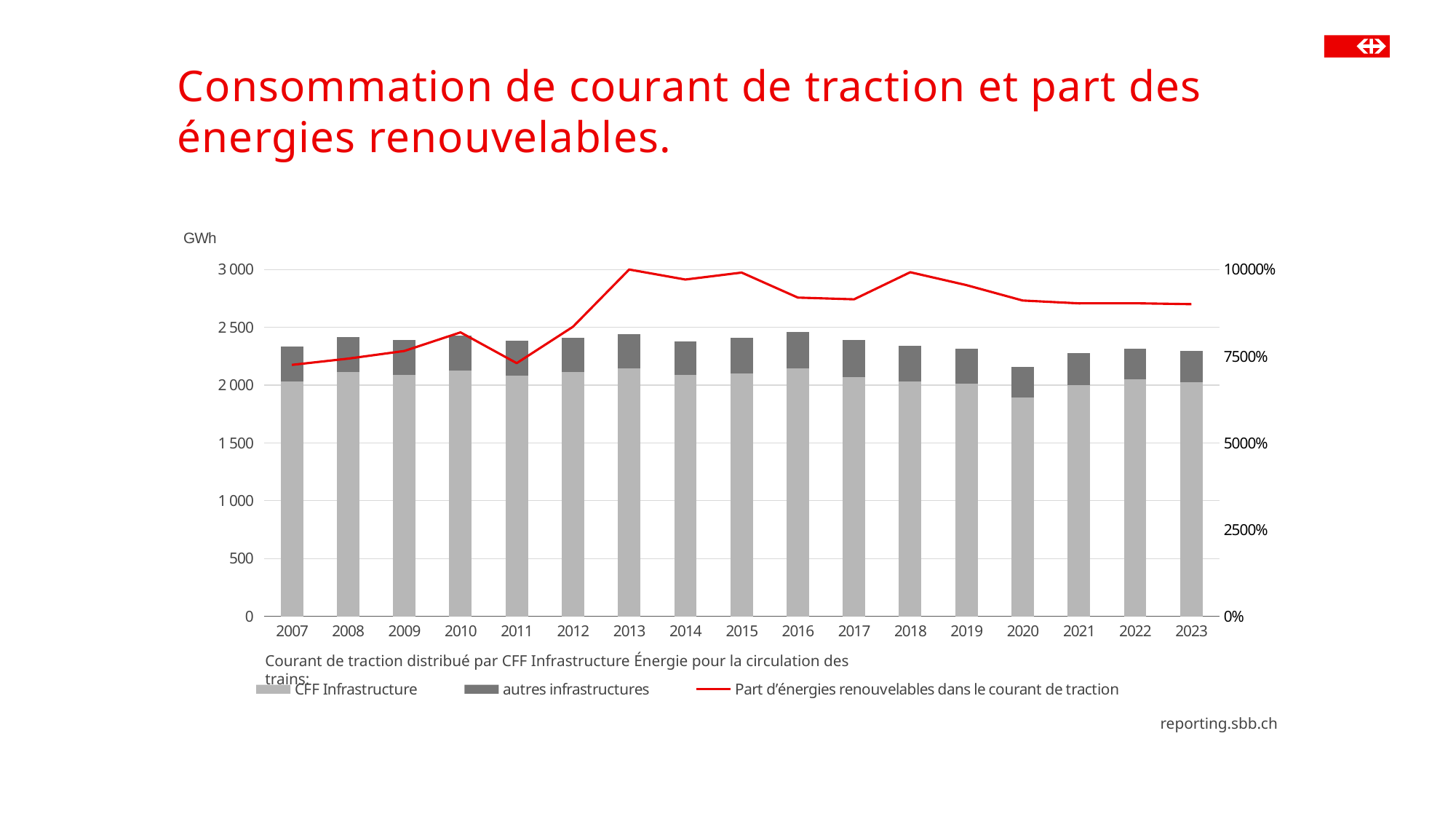
Is the value of the 'Part d'énergies renouvelables dans le courant de traction' line in 2013 greater or less than 7500%? greater Is the 'CFF Infrastructure' segment for 2020 greater or less than 2 000 GWh? less Which year has the larger total stacked bar, 2016 or 2020? 2016 Does the 'Part d'énergies renouvelables' line rise or fall from 2018 to 2023? fall What kind of chart is shown on the slide? A combined bar and line chart (stacked bars with a line) How many series does the chart legend list? 3 Is the total stacked bar for 2020 greater or less than 2 500 GWh? less Is the renewable energy share line higher in 2007 or in 2013? 2013 How many years are shown on the x axis of the chart? 17 What unit is shown on the left vertical axis of the chart? GWh Which year has the lowest total traction current consumption (shortest stacked bar)? 2020